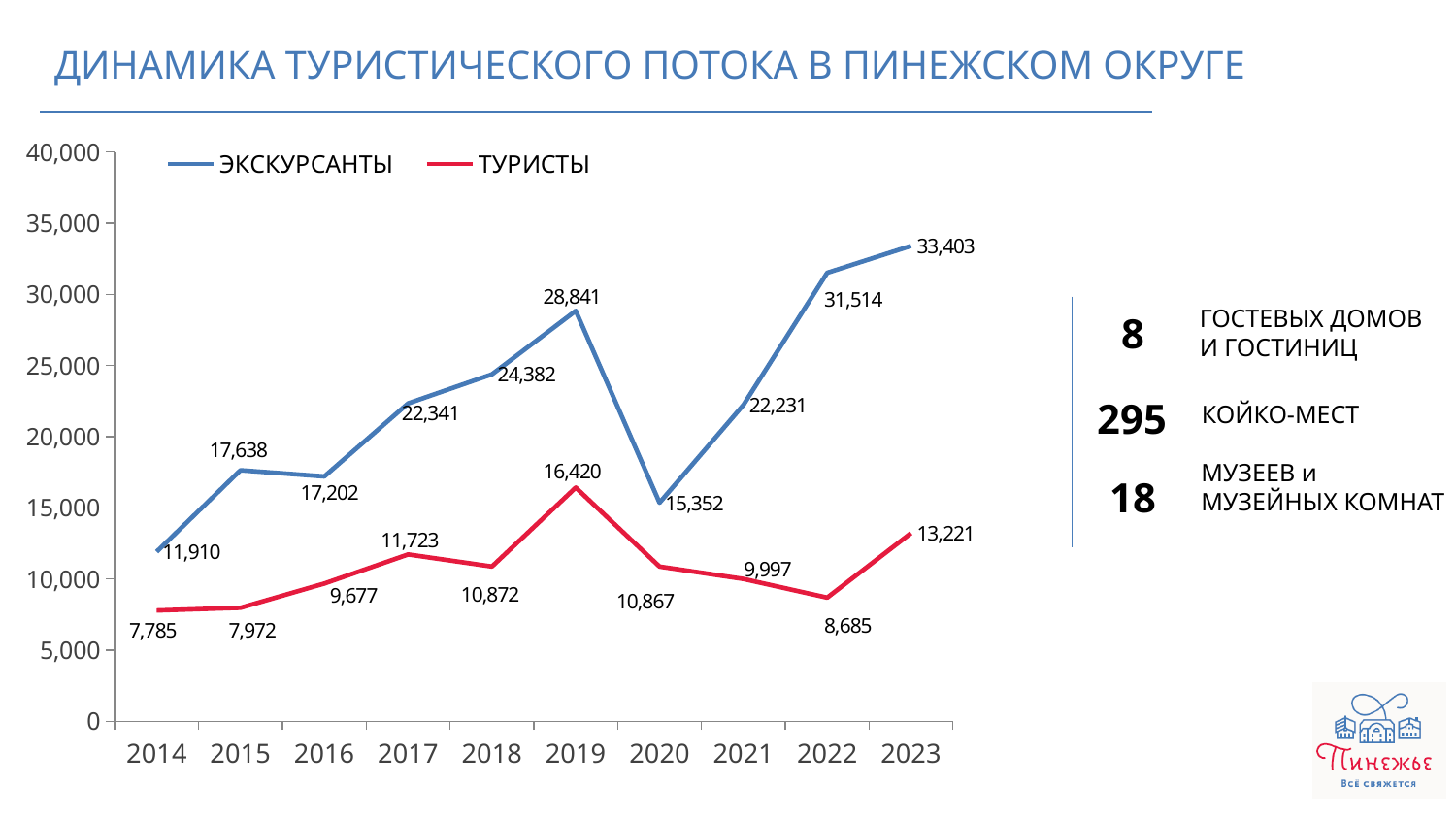
What colour is the line for ТУРИСТЫ? Red What type of chart is shown on the slide? Line chart Which is larger for ЭКСКУРСАНТЫ: the value in 2015 or the value in 2020? 2015 In which year is the ТУРИСТЫ series lowest? 2014 How many years are shown on the x axis? 10 What is the difference between ЭКСКУРСАНТЫ and ТУРИСТЫ in 2023? 20,182 What is the value for ТУРИСТЫ in 2014? 7,785 In which year is the ЭКСКУРСАНТЫ series highest? 2023 How many series does the legend list? 2 Does the ЭКСКУРСАНТЫ series rise or fall from 2019 to 2020? Fall What is the value for ЭКСКУРСАНТЫ in 2019? 28,841 What is the value for ТУРИСТЫ in 2023? 13,221